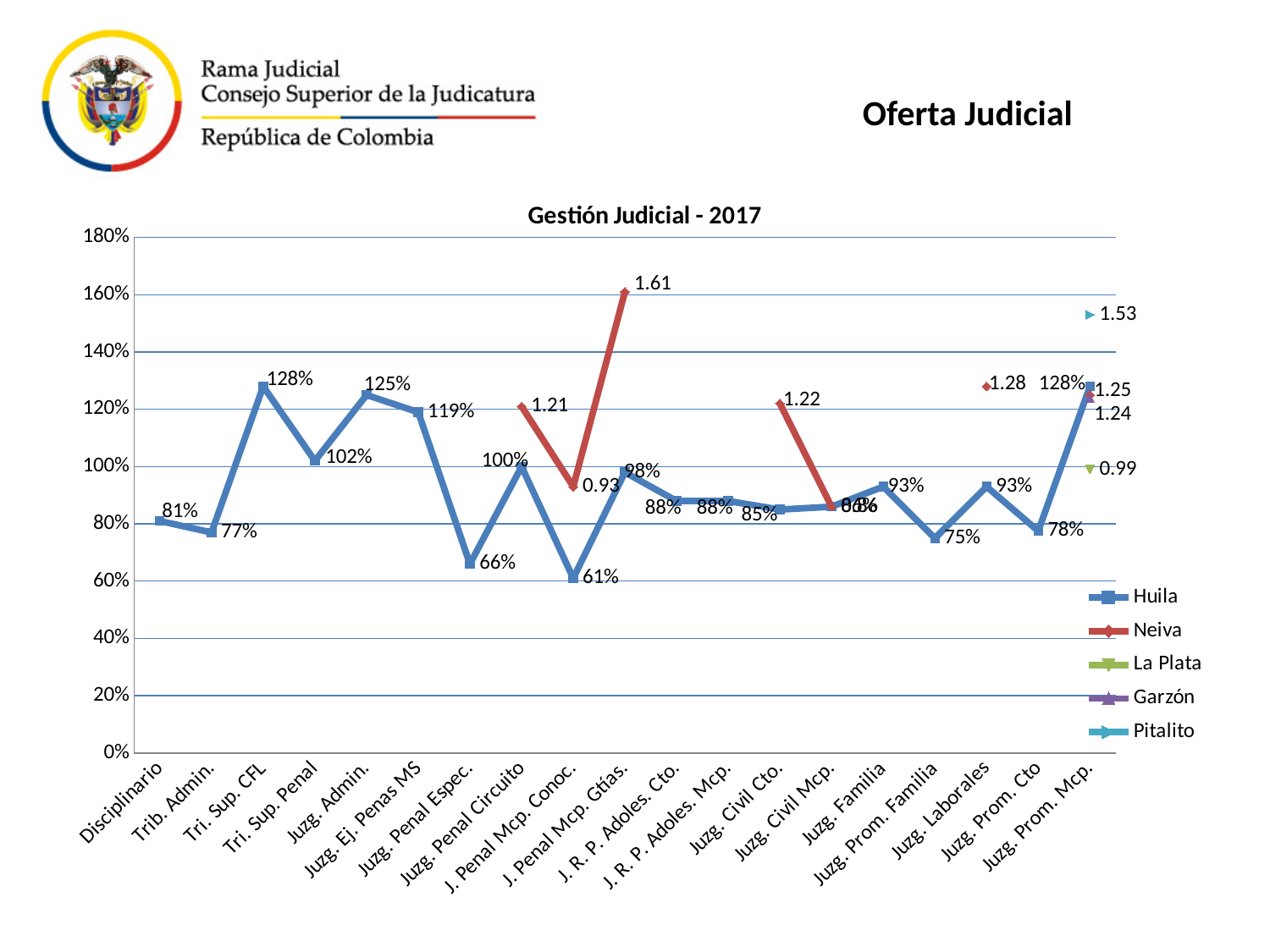
What is the difference between the Huila values for Juzg. Admin. and Juzg. Ej. Penas MS? 6 percentage points What is the Neiva value for J. Penal Mcp. Gtías.? 1.61 What is the La Plata value for Juzg. Prom. Mcp.? 0.99 Which category has the lowest Huila value? J. Penal Mcp. Conoc. What is the Huila value for Tri. Sup. CFL? 128% What is the title of the chart? Gestión Judicial - 2017 Which category has the highest Neiva value? J. Penal Mcp. Gtías. What kind of chart is shown? Line chart How many series does the legend list? 5 What is the Pitalito value for Juzg. Prom. Mcp.? 1.53 What is the Huila value for Juzg. Penal Espec.? 66% Which has the larger Huila value, Disciplinario or Trib. Admin.? Disciplinario